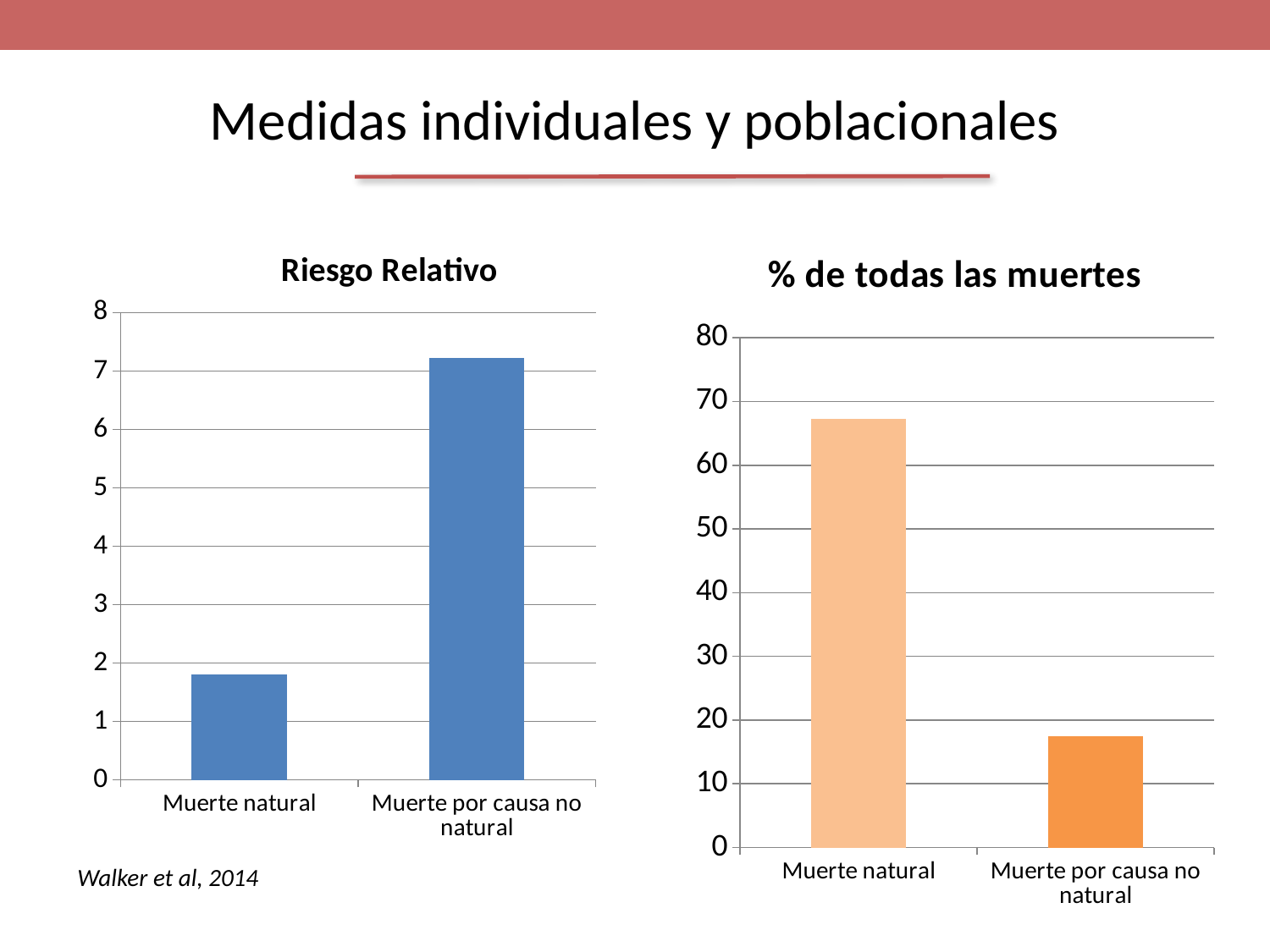
What is the title of the chart on the left side of the slide? Riesgo Relativo In the '% de todas las muertes' chart, is the value for Muerte por causa no natural greater or less than 20? less In the 'Riesgo Relativo' chart, which category has the lowest value? Muerte natural In the '% de todas las muertes' chart, which category has the highest value? Muerte natural What kind of chart is the '% de todas las muertes' chart? Bar chart In the 'Riesgo Relativo' chart, is the value for Muerte natural greater or less than 2? less In the '% de todas las muertes' chart, which category has the lowest value? Muerte por causa no natural In the 'Riesgo Relativo' chart, which category has the highest value? Muerte por causa no natural How many categories are shown in the 'Riesgo Relativo' chart? 2 In the 'Riesgo Relativo' chart, is the value for Muerte por causa no natural greater or less than 7? greater In the '% de todas las muertes' chart, which is larger: the value for Muerte natural or for Muerte por causa no natural? Muerte natural